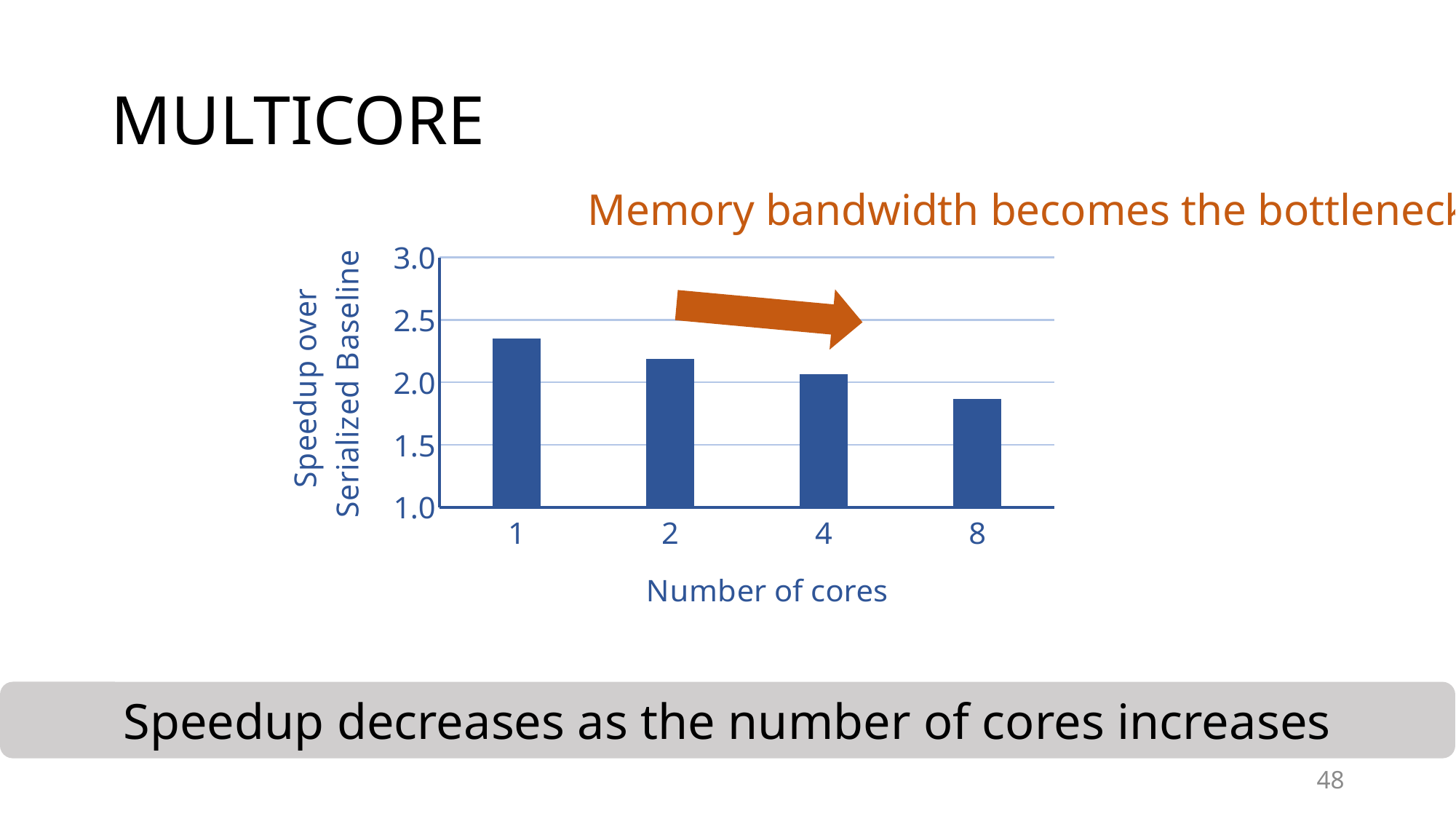
How many bars (core counts) are plotted in the chart? 4 Is the speedup for 1 core greater or less than 2.5? less Is the speedup for 8 cores greater or less than 2.0? less Is the speedup for 1 core greater or less than 2.0? greater What kind of chart is shown on the slide? bar chart Which has the larger speedup: 1 core or 8 cores? 1 core Do the speedup values rise or fall as the number of cores increases along the x axis? fall Which number of cores has the lowest speedup over the serialized baseline? 8 What is the label of the x axis of the chart? Number of cores Which number of cores has the highest speedup over the serialized baseline? 1 What is the label of the y axis of the chart? Speedup over Serialized Baseline